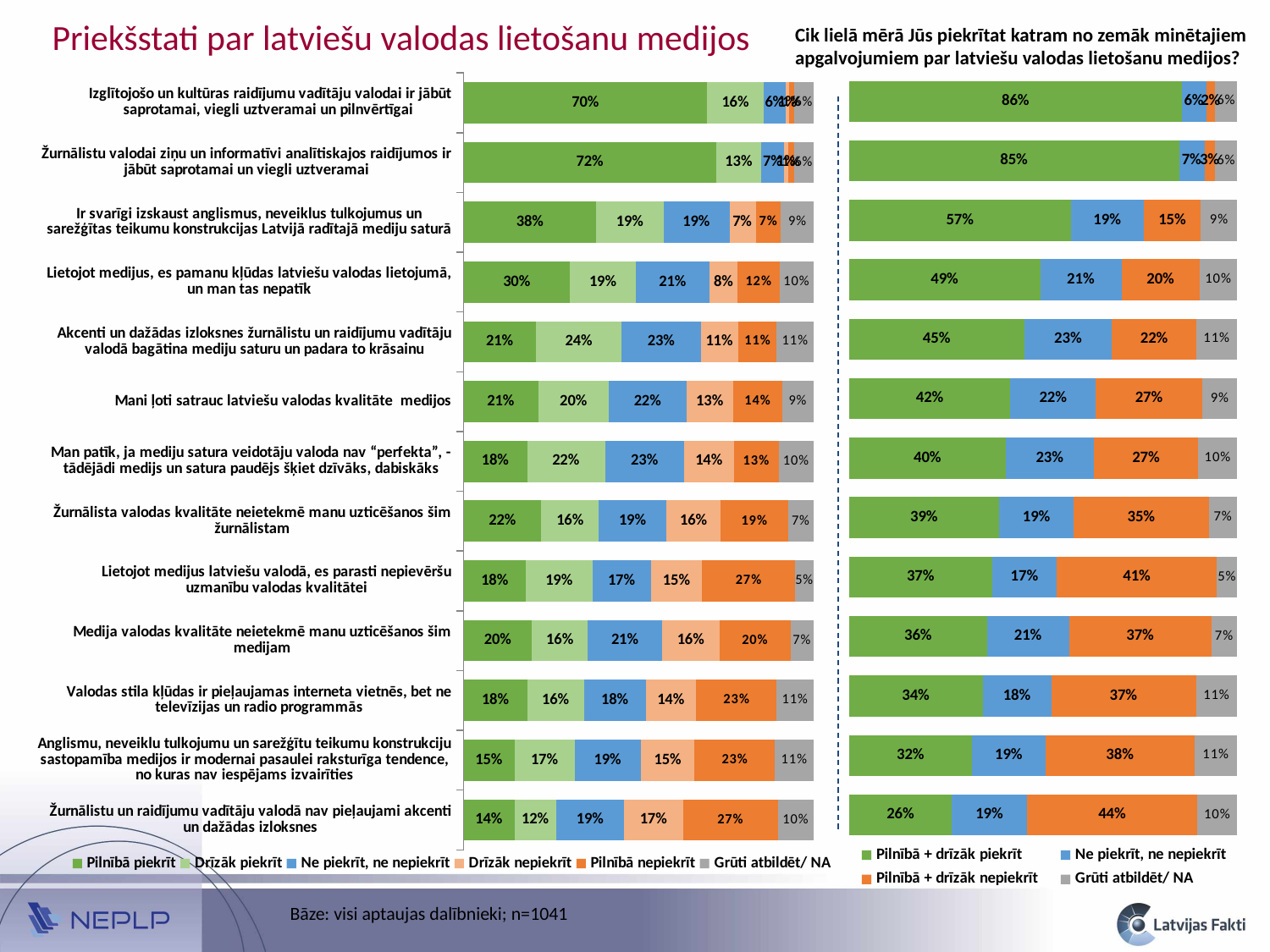
How many series does the legend of the left chart list? 6 In the left chart, which statement has the lowest 'Pilnībā piekrīt' value? Žurnālistu un raidījumu vadītāju valodā nav pieļaujami akcenti un dažādas izloksnes (14%) In the right chart, what is the total of the stacked bar for 'Ir svarīgi izskaust anglismus, neveiklus tulkojumus un sarežģītas teikumu konstrukcijas Latvijā radītajā mediju saturā'? 100% In the right chart, for 'Lietojot medijus latviešu valodā, es parasti nepievēršu uzmanību valodas kvalitātei', which is larger: 'Pilnībā + drīzāk piekrīt' or 'Pilnībā + drīzāk nepiekrīt'? Pilnībā + drīzāk nepiekrīt (41%) In the right chart, what is the difference in 'Pilnībā + drīzāk piekrīt' between the first statement (86%) and the last statement (26%)? 60 percentage points How many series does the legend of the right chart list? 4 In the right chart, what is the 'Pilnībā + drīzāk nepiekrīt' value for 'Mani ļoti satrauc latviešu valodas kvalitāte medijos'? 27% In the right chart, which statement has the highest 'Pilnībā + drīzāk piekrīt' value? Izglītojošo un kultūras raidījumu vadītāju valodai ir jābūt saprotamai, viegli uztveramai un pilnvērtīgai (86%) How many statements (categories) are plotted in the right chart? 13 What is the base (sample size) stated at the bottom of the slide? n=1041 In the left chart, what is the 'Pilnībā piekrīt' value for 'Ir svarīgi izskaust anglismus, neveiklus tulkojumus un sarežģītas teikumu konstrukcijas Latvijā radītajā mediju saturā'? 38% What kind of chart is the left chart on the slide? Stacked bar chart